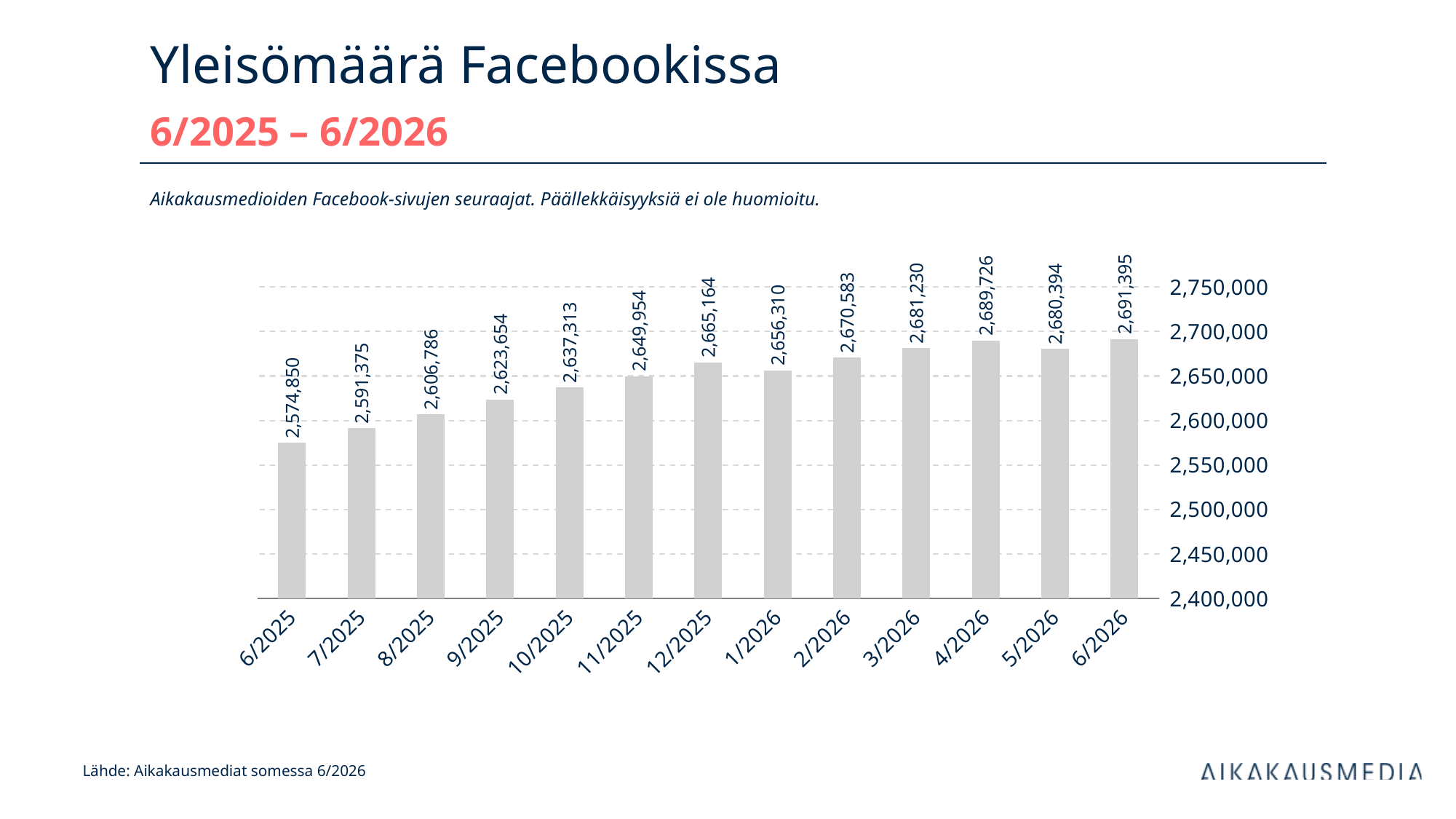
Which month has the lowest value? 6/2025 What is the value for 6/2026? 2,691,395 What is the value for 1/2026? 2,656,310 What is the title of the chart? Yleisömäärä Facebookissa What is the value for 6/2025? 2,574,850 What is the difference between the values for 6/2026 and 6/2025? 116,545 What kind of chart is shown on the slide? bar chart Which is larger, the value for 4/2026 or the value for 5/2026? 4/2026 What is the difference between the values for 12/2025 and 1/2026? 8,854 How many months are shown on the x axis? 13 Is the value for 9/2025 greater or less than 2,600,000? greater Which month has the highest value? 6/2026